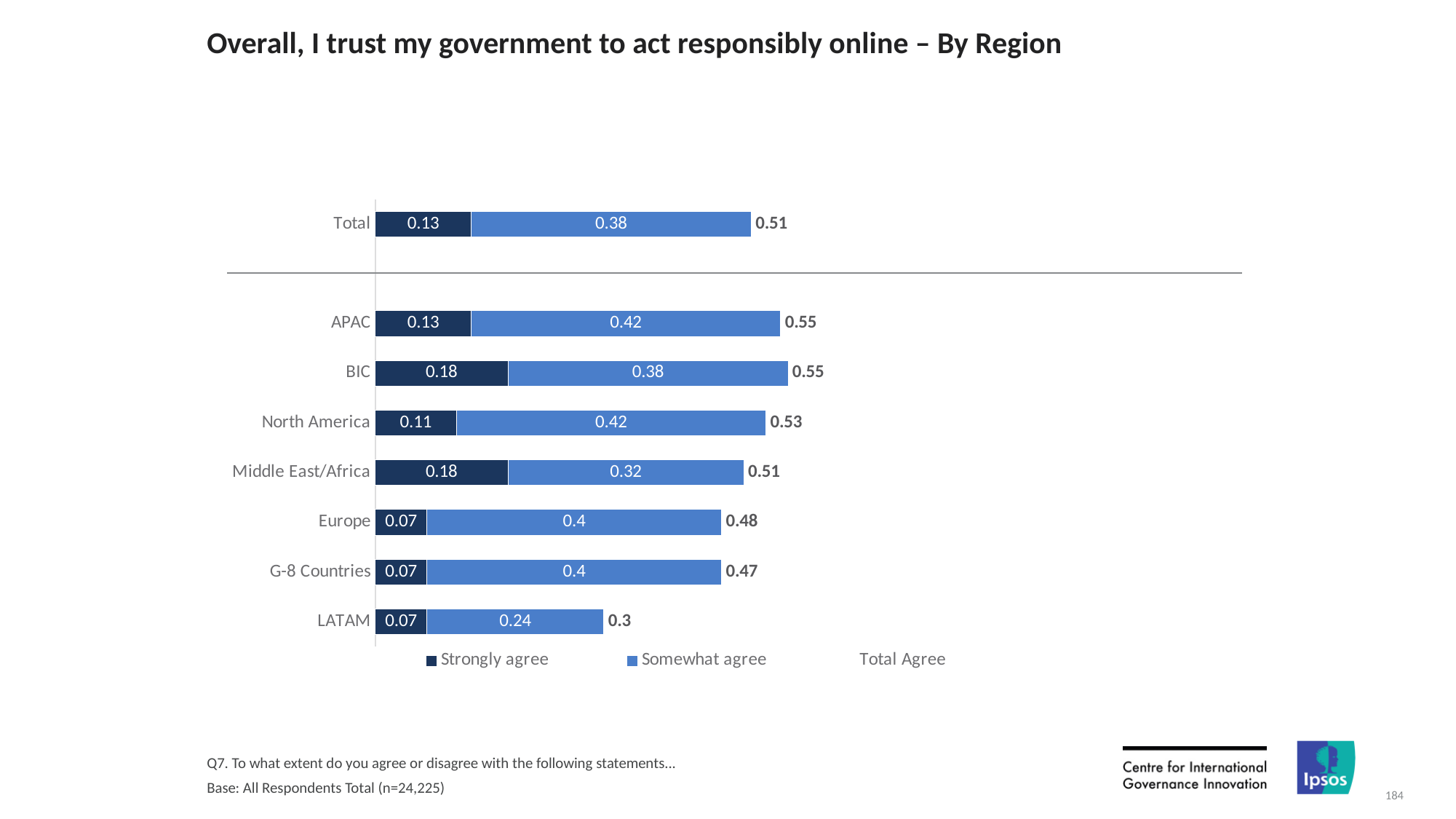
What is the difference between the Strongly agree values for BIC and Europe? 0.11 What is the Total Agree value for North America? 0.53 Which region has the lowest Total Agree value? LATAM What is the Total Agree value for LATAM? 0.3 How many series does the legend list? 3 How many regional categories are shown below the Total bar? 7 What is the Somewhat agree value for Middle East/Africa? 0.32 Which region has the highest Somewhat agree value, APAC or Middle East/Africa? APAC What is the Strongly agree value for BIC? 0.18 Is the Strongly agree value for Middle East/Africa larger or smaller than the Strongly agree value for North America? larger What is the difference between the Total Agree values for APAC and LATAM? 0.25 What type of chart is shown on the slide? Stacked bar chart